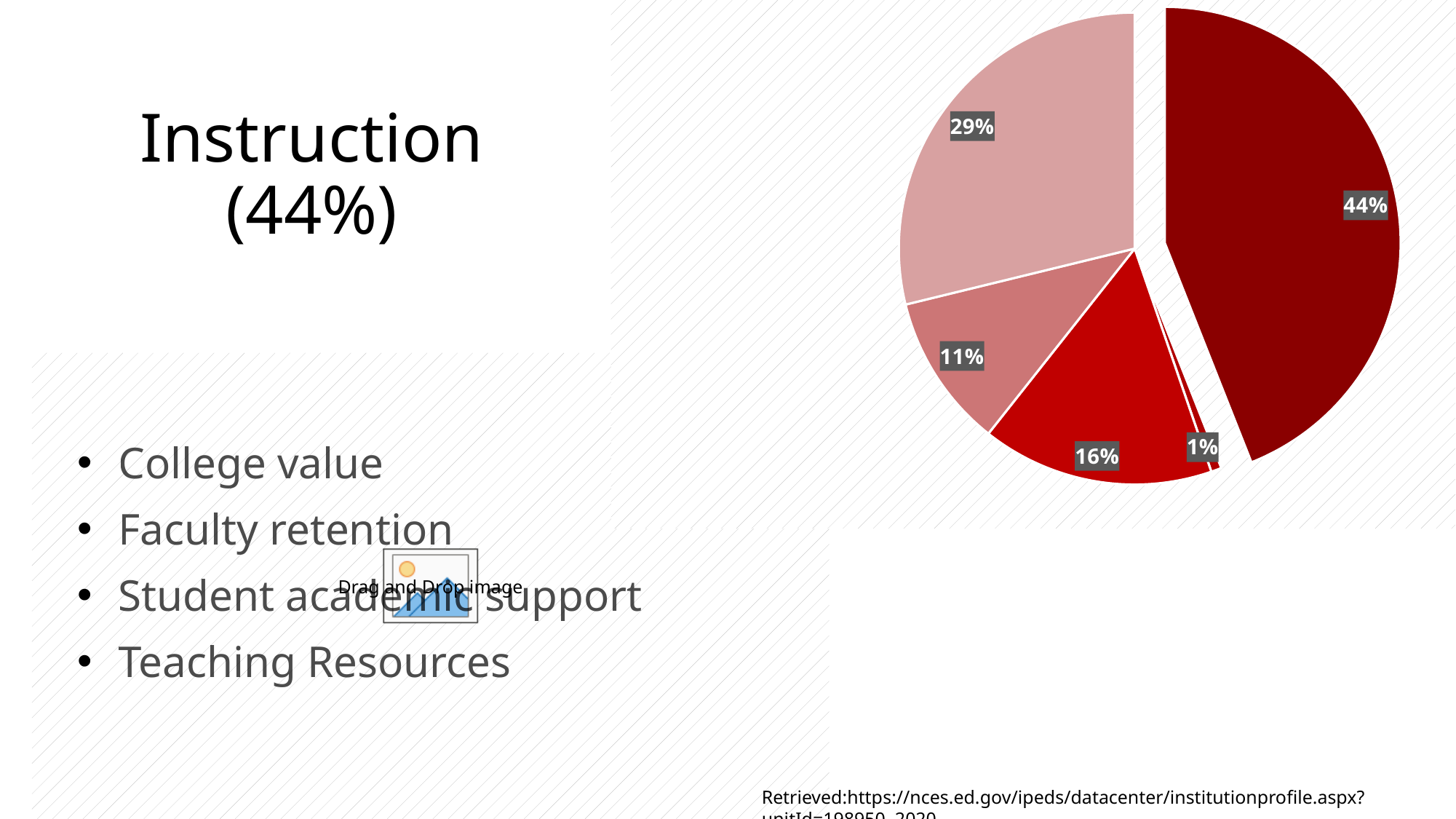
How many slices does the pie chart have? 5 Which slice of the pie chart is pulled out (exploded) from the rest? the 44% slice What is the difference between the largest slice (44%) and the second-largest slice (29%) in the pie chart? 15% What is the difference between the 16% slice and the 11% slice in the pie chart? 5% Is the 29% slice of the pie chart greater or less than 25%? greater Which is larger in the pie chart, the 29% slice or the 16% slice? 29% What is the largest percentage shown on the pie chart? 44% According to the slide, what share of the pie does Instruction represent? 44% What kind of chart is shown on the slide? pie chart What colour is the largest (44%) slice of the pie chart? dark red What is the combined share of the 11% and 16% slices in the pie chart? 27% What is the smallest percentage shown on the pie chart? 1%